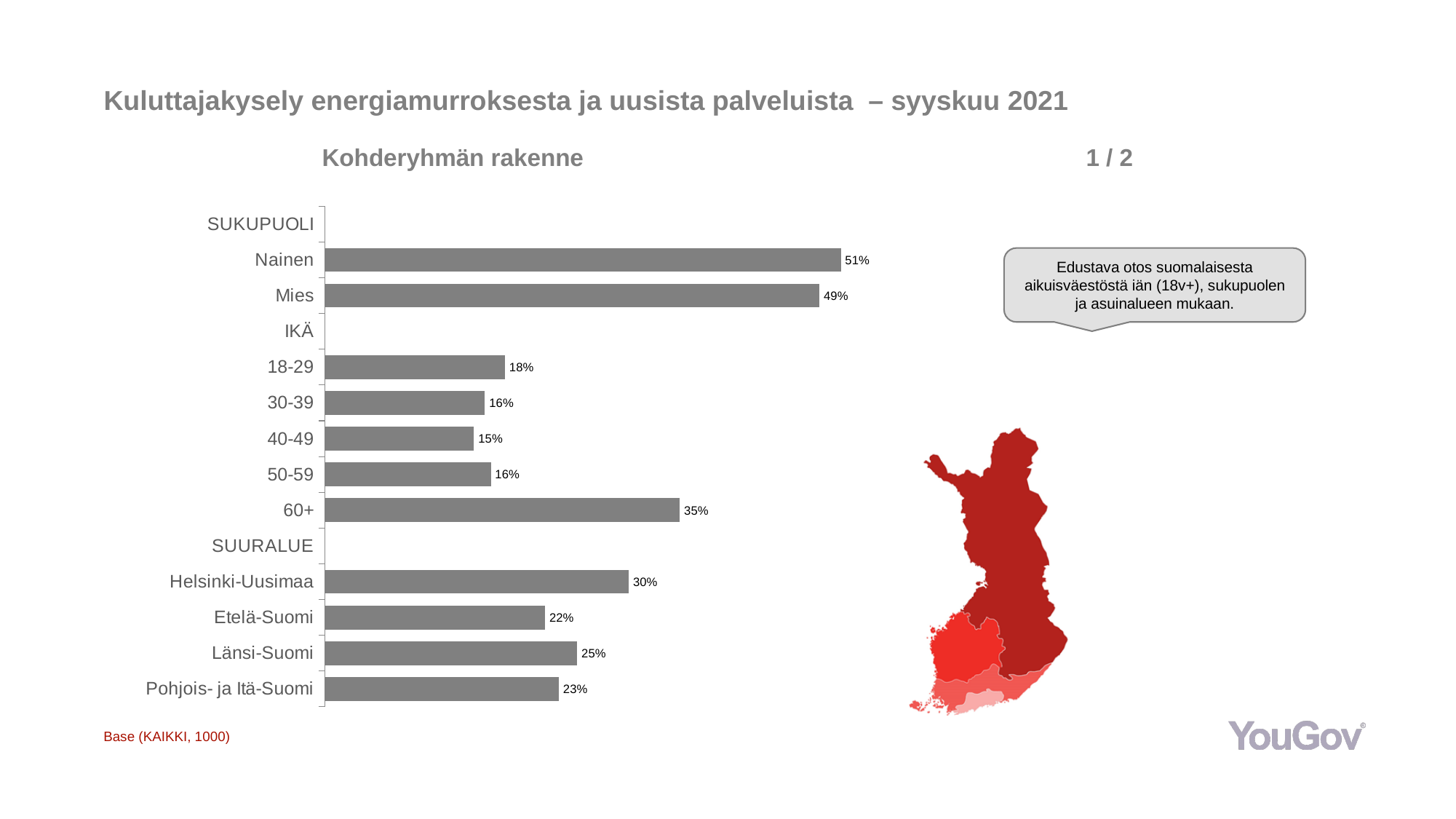
What is the difference between the values for 60+ and 18-29? 17% What is the value for Nainen? 51% Which age group (IKÄ) has the lowest value? 40-49 What kind of chart is shown on the slide? Bar chart Which age group (IKÄ) has the highest value? 60+ Which is larger, the value for Länsi-Suomi or Etelä-Suomi? Länsi-Suomi What is the value for 60+? 35% What is the value for Pohjois- ja Itä-Suomi? 23% What is the title of the chart? Kohderyhmän rakenne What is the value for Helsinki-Uusimaa? 30% What is the difference between the values for Nainen and Mies? 2% Which region under SUURALUE has the lowest value? Etelä-Suomi